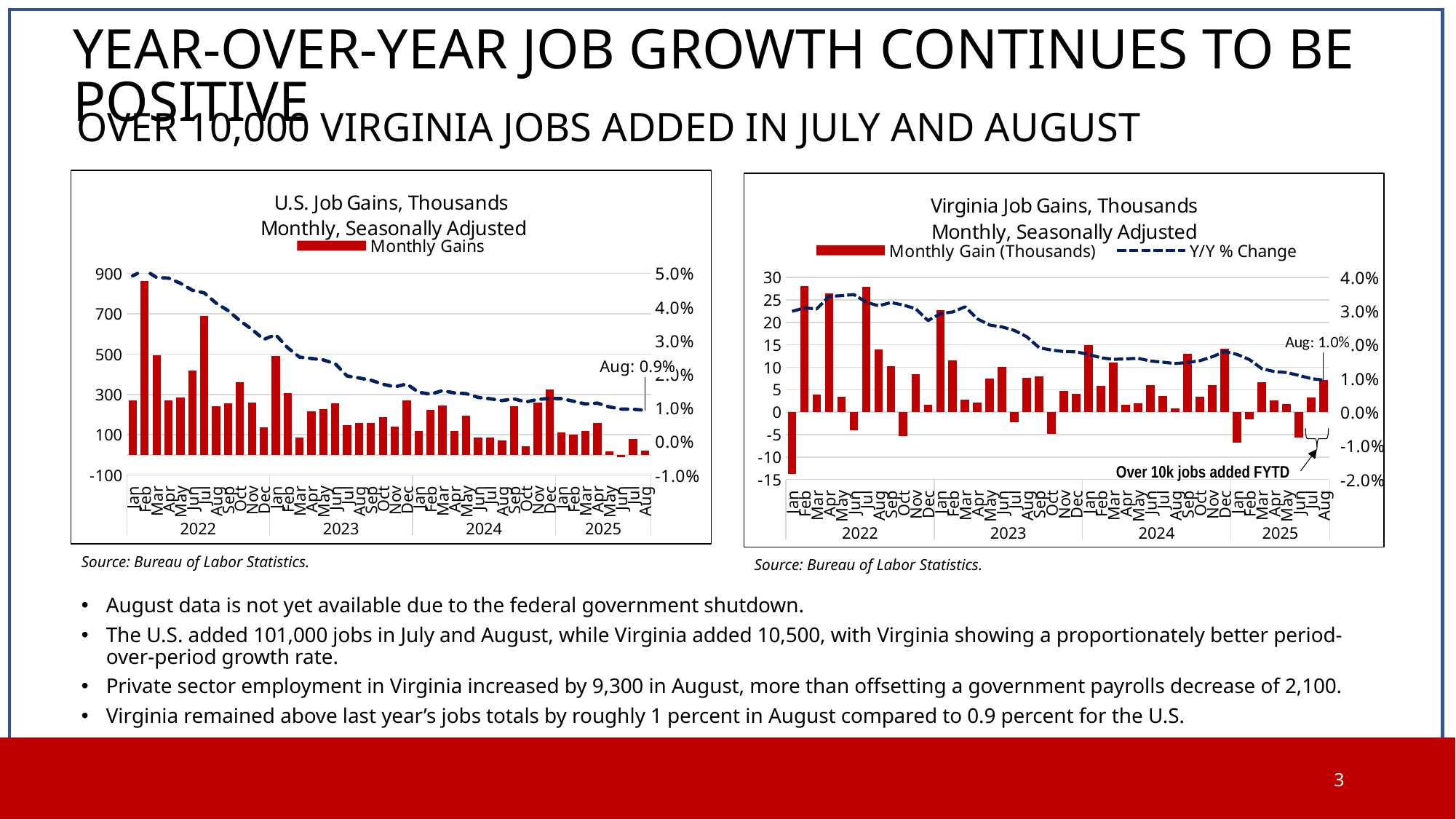
In the Virginia Job Gains chart, which is larger, the monthly gain bar for Feb 2022 or for Jan 2023? Feb 2022 In the Virginia Job Gains chart, is the monthly gain for Jan 2022 greater or less than -10? less What annotation text appears near the bottom right of the Virginia Job Gains chart? Over 10k jobs added FYTD What kind of chart is the U.S. Job Gains chart on the left? bar chart with a line In the U.S. Job Gains chart, is the monthly gain for Jul 2022 greater or less than 500? greater In the U.S. Job Gains chart, how many series does the legend list? 1 In the Virginia Job Gains chart, what is the labeled year-over-year percent change for August 2025? 1.0% In the Virginia Job Gains chart, which month has the lowest monthly gain bar? Jan 2022 In the Virginia Job Gains chart, how many series does the legend list? 2 In the U.S. Job Gains chart, does the dashed year-over-year percent change line generally rise or fall from 2022 to 2025? fall In the U.S. Job Gains chart, which month has the highest monthly gain bar? Feb 2022 In the U.S. Job Gains chart, what is the labeled year-over-year percent change for August 2025? 0.9%